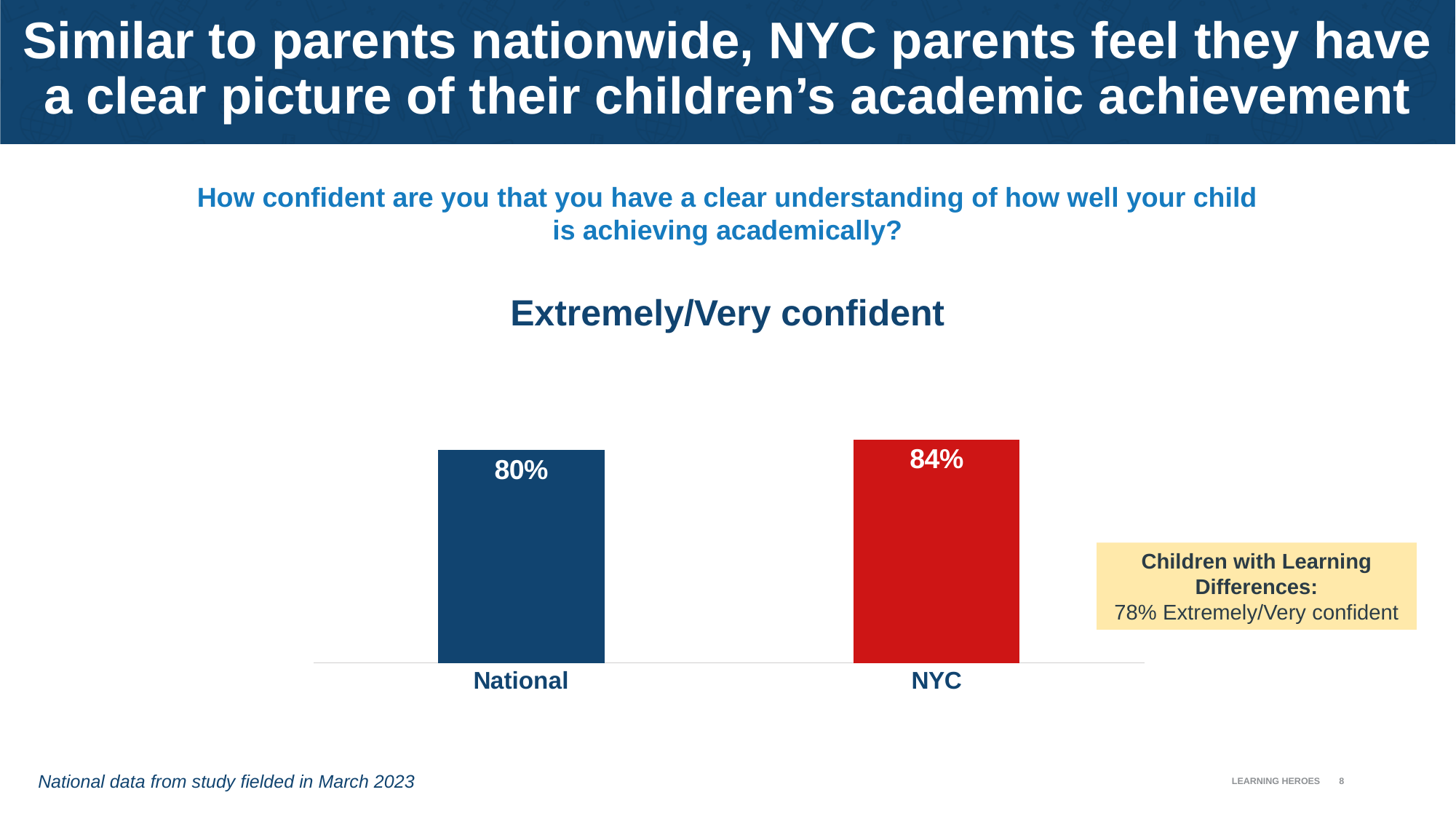
What is the title of the chart? Extremely/Very confident Which category has the lowest value? National What is the value for NYC? 84% Which category has the highest value? NYC What is the difference between the NYC and National values? 4% How many categories are shown in the chart? 2 Do the values rise or fall from National to NYC? Rise What colour is the NYC bar? Red Which is larger, the value for National or the value for NYC? NYC What is the value for National? 80% What kind of chart is shown on the slide? Bar chart